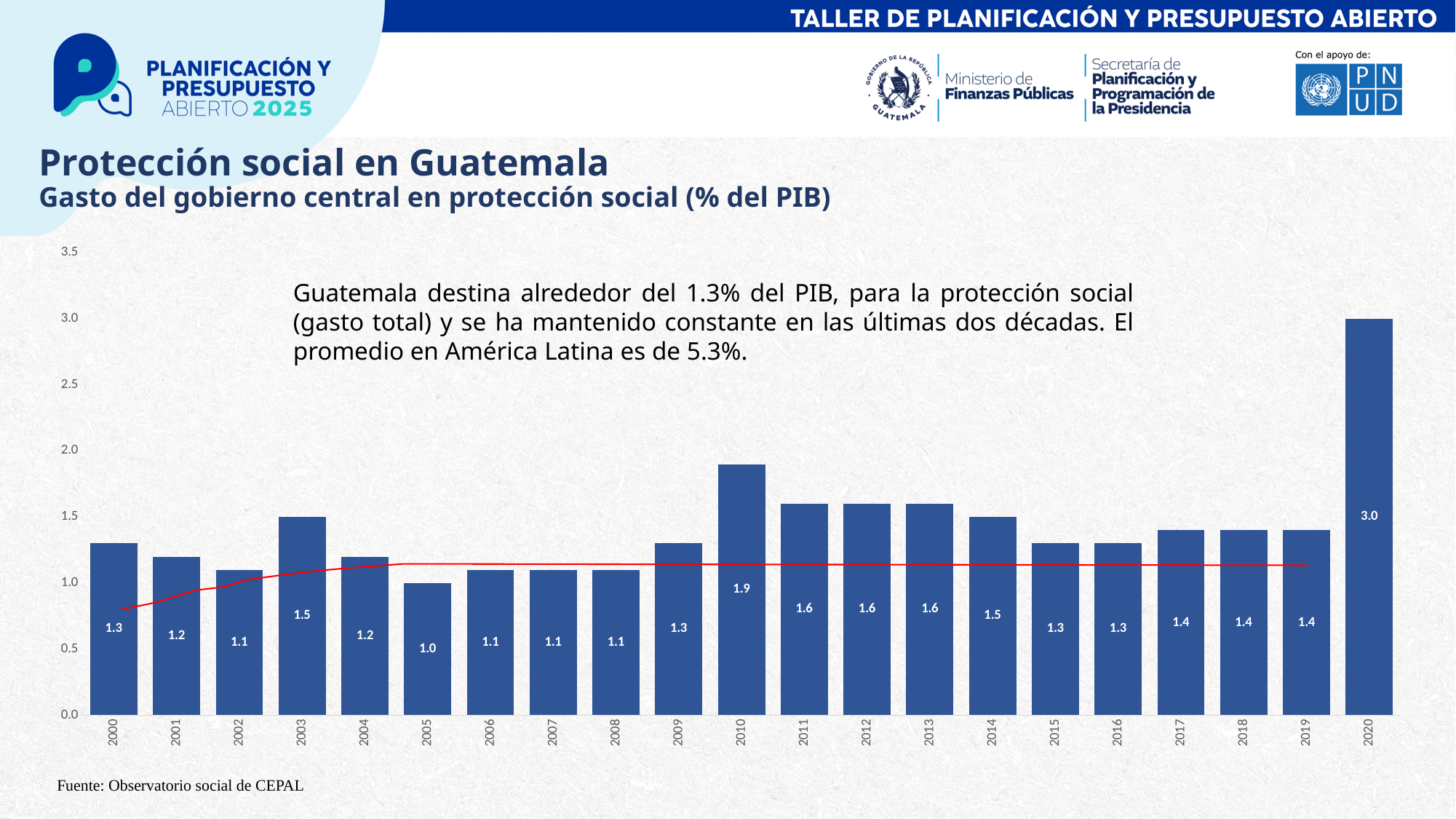
Which year has the highest value? 2020 What is the value for 2010? 1.9 What is the value for 2020? 3.0 What is the value for 2003? 1.5 What kind of chart is shown on the slide? Bar chart What is the value for 2005? 1.0 Which is larger, the value for 2011 or the value for 2014? 2011 Is the value for 2010 greater or less than 1.5? greater What is the difference between the values for 2010 and 2009? 0.6 What is the difference between the values for 2020 and 2019? 1.6 Which year has the lowest value? 2005 How many years are shown on the x axis? 21